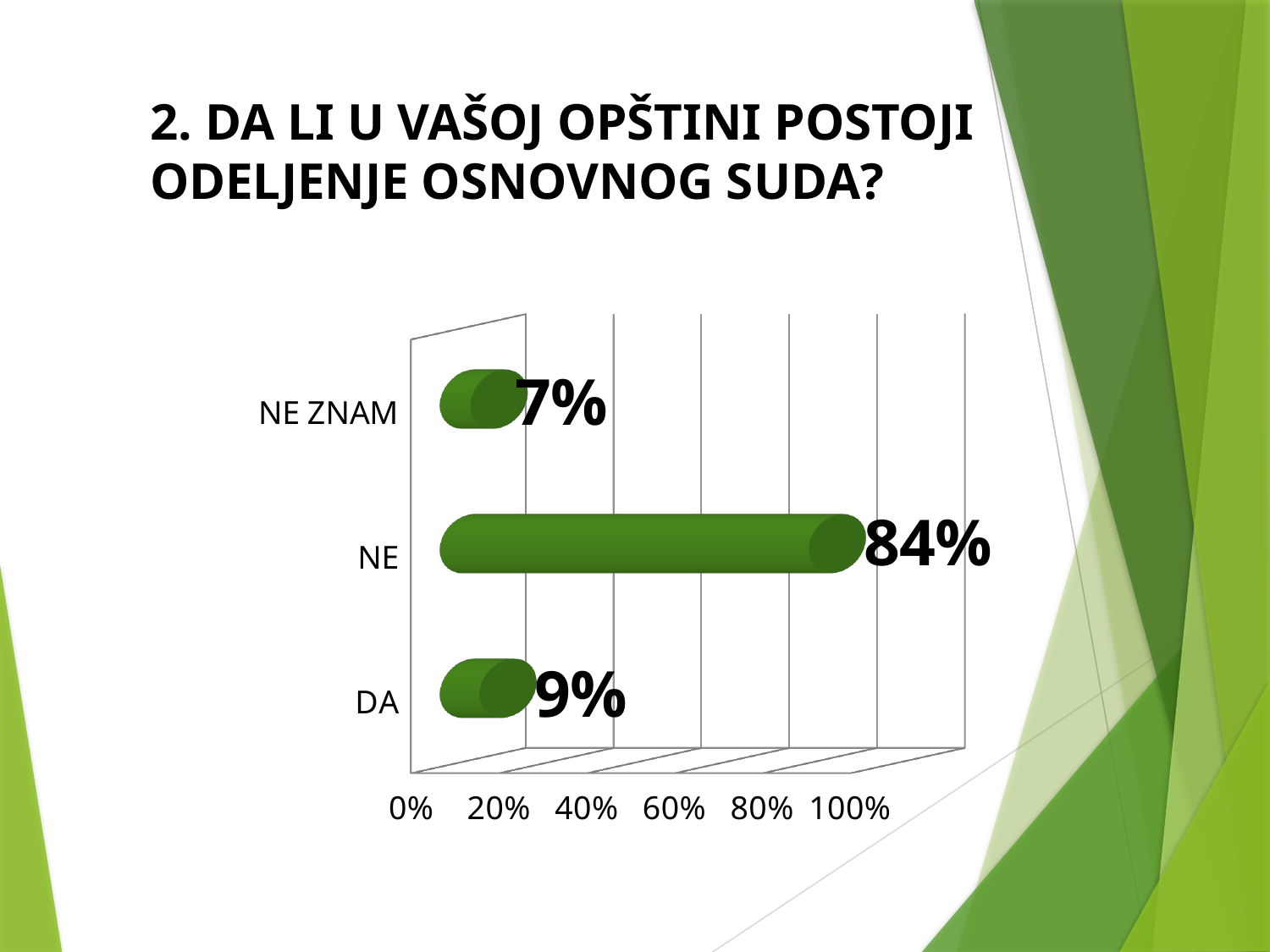
Which category has the highest value? NE Which is larger, the value for DA or the value for NE ZNAM? DA What kind of chart is shown on the slide? bar chart What is the title of the slide above the chart? 2. DA LI U VAŠOJ OPŠTINI POSTOJI ODELJENJE OSNOVNOG SUDA? What is the value for NE? 84% What is the value for DA? 9% How many categories are shown in the chart? 3 Which category has the lowest value? NE ZNAM Is the value for NE greater or less than 80%? greater What is the difference between the values for DA and NE ZNAM? 2% What is the value for NE ZNAM? 7% What is the difference between the values for NE and DA? 75%